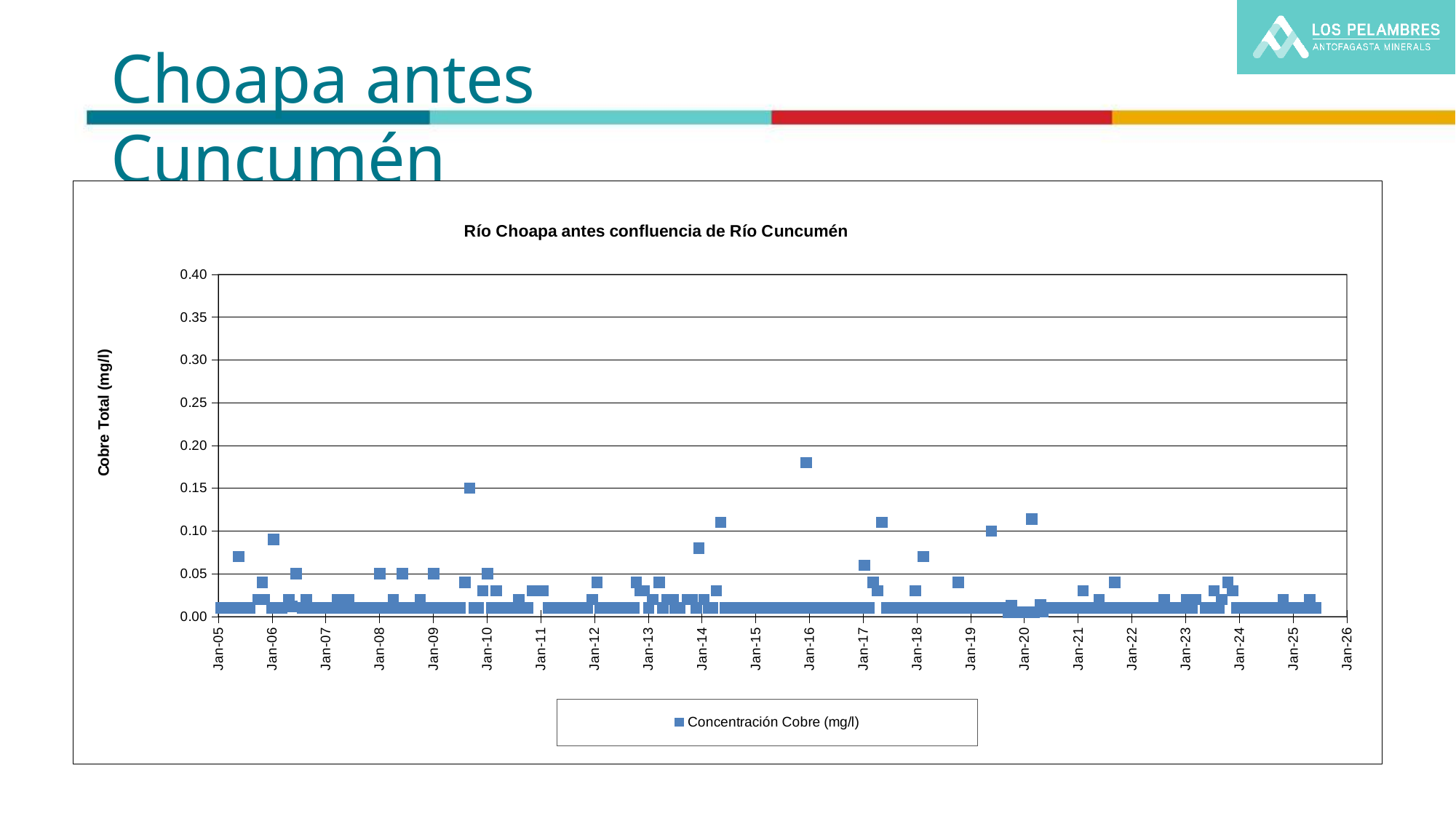
What is the legend entry for the plotted series? Concentración Cobre (mg/l) Near which x-axis label does the highest copper concentration point appear? Jan-16 Is the highest plotted copper concentration greater or less than 0.20 mg/l? less What is the title of the chart? Río Choapa antes confluencia de Río Cuncumén Is the highest plotted copper concentration greater or less than 0.15 mg/l? greater Which is larger: the copper concentration point just before Jan-16 or the point just before Jan-10? The point just before Jan-16 What is the maximum value shown on the y axis? 0.40 How many labelled tick marks are on the x axis, from Jan-05 to Jan-26? 22 How many series does the legend list? 1 What kind of chart is shown on the slide? Scatter chart